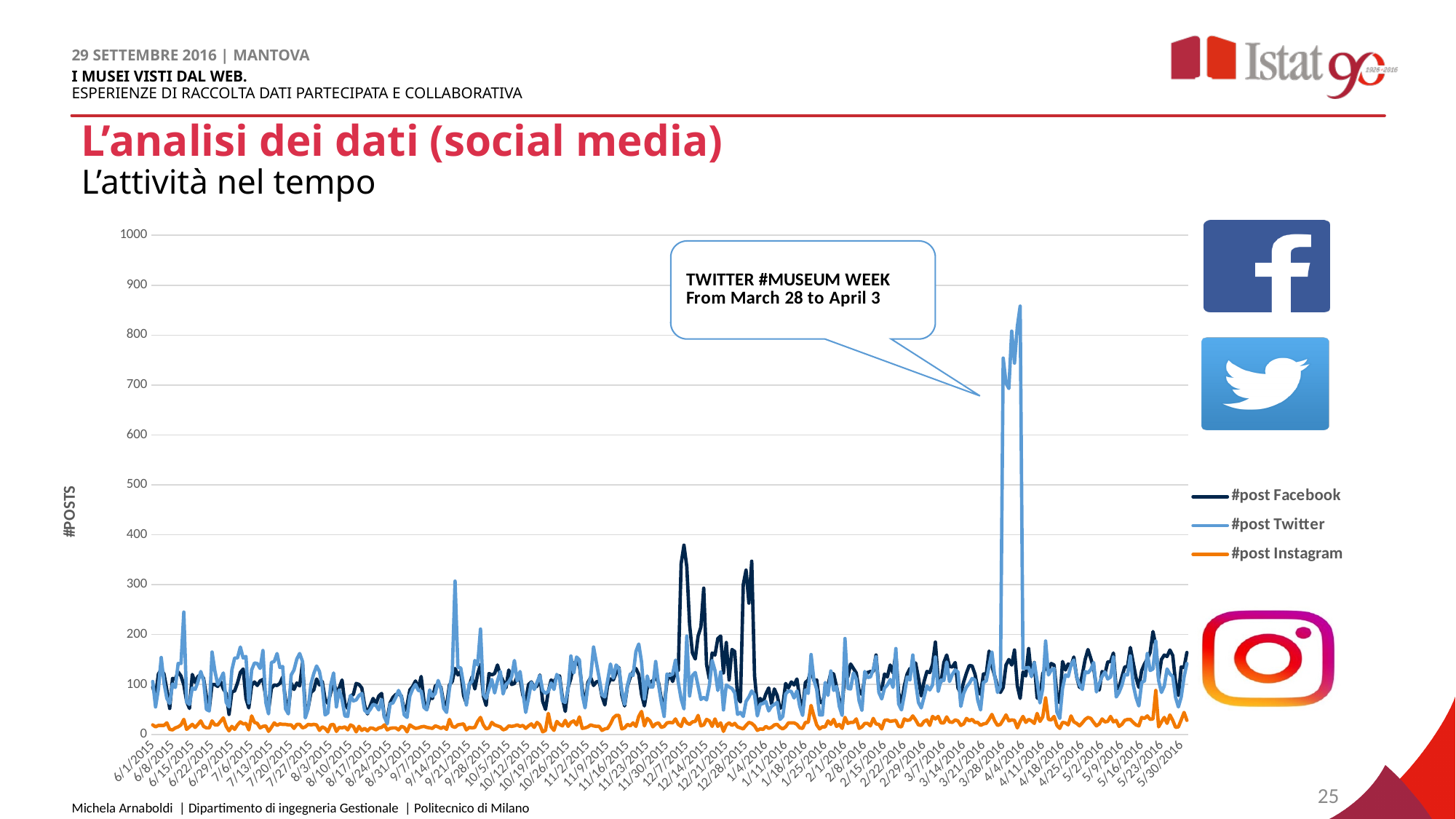
Which series reaches the highest peak on the chart? #post Twitter Which is larger: the highest peak of #post Twitter or the highest peak of #post Facebook? #post Twitter What is the first date shown on the x axis of the chart? 6/1/2015 Is the highest peak of #post Facebook (around December 2015) greater or less than 300? greater What is the last date shown on the x axis of the chart? 5/30/2016 What kind of chart is shown on the slide? line chart Is the highest peak of #post Twitter greater or less than 800? greater Is the highest value of #post Instagram greater or less than 100? less How many series does the chart legend list? 3 What is the label on the vertical axis of the chart? #POSTS What are the three series listed in the chart legend? #post Facebook, #post Twitter, #post Instagram Which series stays lowest across the whole period? #post Instagram